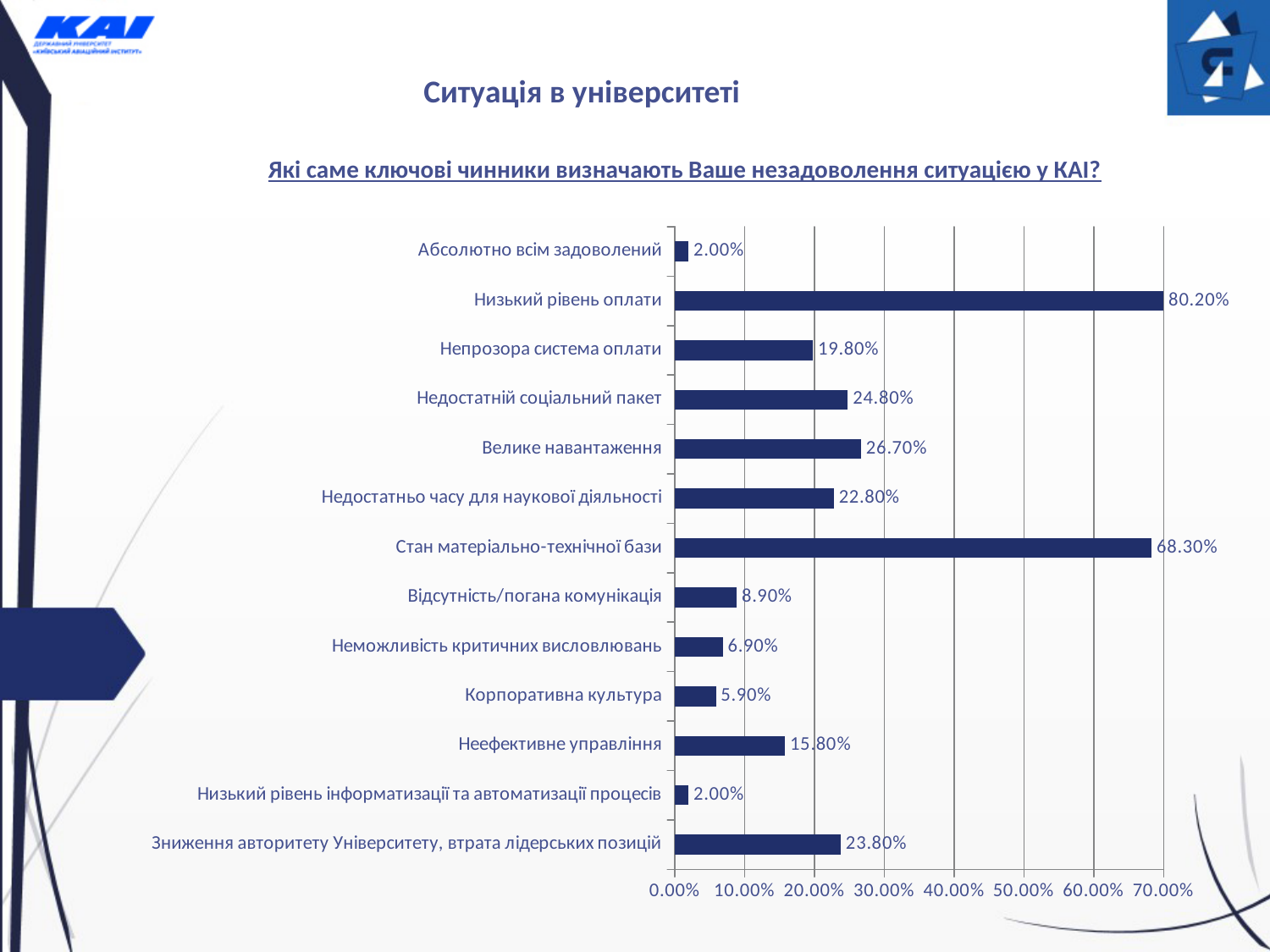
Is the value for "Недостатній соціальний пакет" greater or less than 20.00%? greater What kind of chart is shown on the slide? bar chart Which category has the highest value? Низький рівень оплати What is the value for "Неефективне управління"? 15.80% What is the value for "Низький рівень оплати"? 80.20% What is the value for "Зниження авторитету Університету, втрата лідерських позицій"? 23.80% What is the value for "Стан матеріально-технічної бази"? 68.30% What is the difference between the values for "Низький рівень оплати" and "Стан матеріально-технічної бази"? 11.90% How many categories are shown in the chart? 13 What is the lowest value shown in the chart? 2.00% What is the value for "Корпоративна культура"? 5.90% Which is larger: the value for "Велике навантаження" or the value for "Недостатньо часу для наукової діяльності"? Велике навантаження